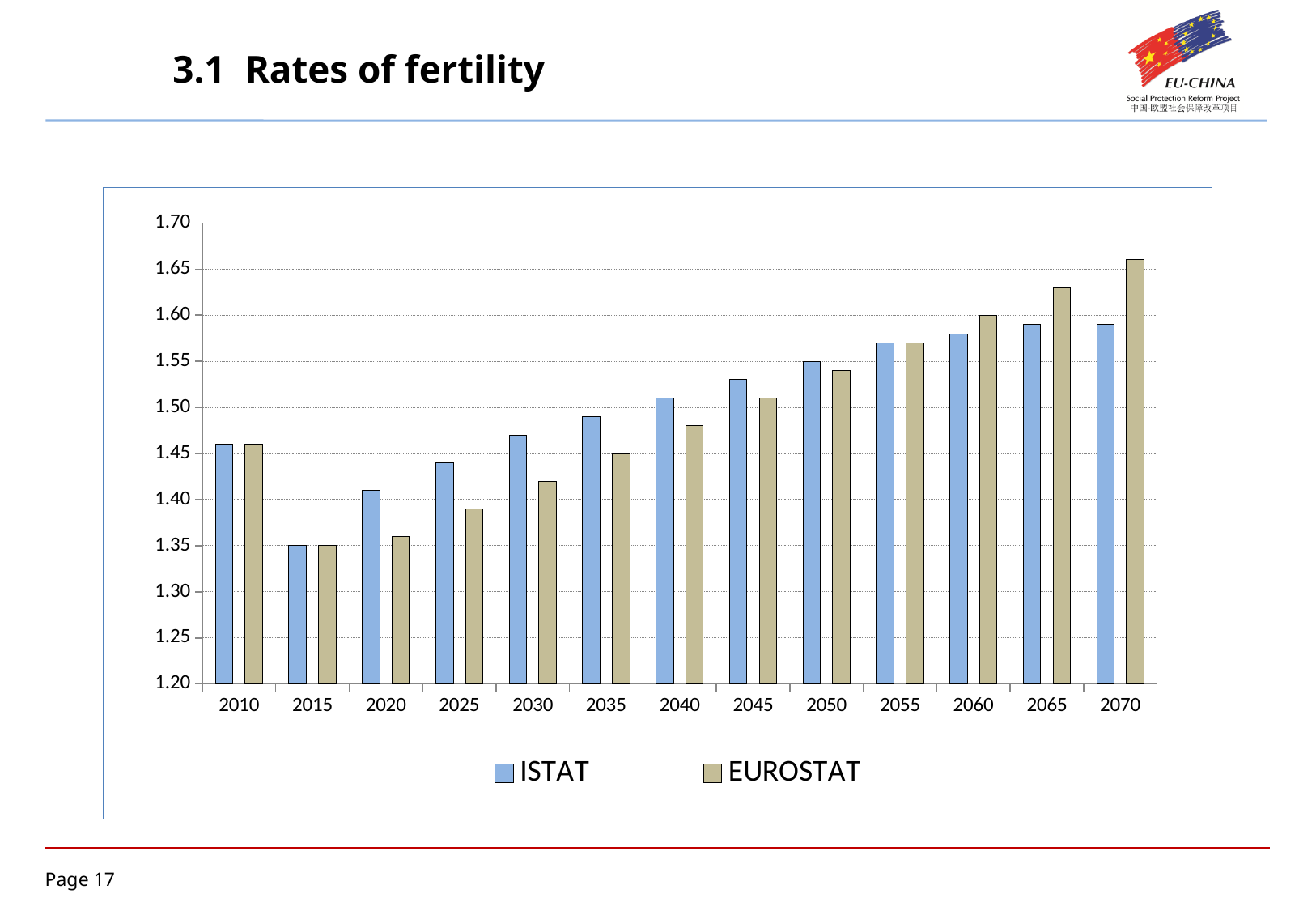
Is the ISTAT value for 2045 greater or less than 1.50? greater Is the EUROSTAT value for 2065 greater or less than 1.60? greater In 2070, which series shows the higher fertility rate, ISTAT or EUROSTAT? EUROSTAT What kind of chart is shown on the slide? bar chart How many series does the legend list? 2 Is the EUROSTAT value for 2020 greater or less than 1.40? less In 2030, which series shows the higher fertility rate, ISTAT or EUROSTAT? ISTAT What colour are the ISTAT bars? blue From 2015 to 2070, do the EUROSTAT fertility rates rise or fall? rise Which year has the lowest ISTAT fertility rate? 2015 Which year has the highest EUROSTAT fertility rate? 2070 How many years are shown along the x axis? 13